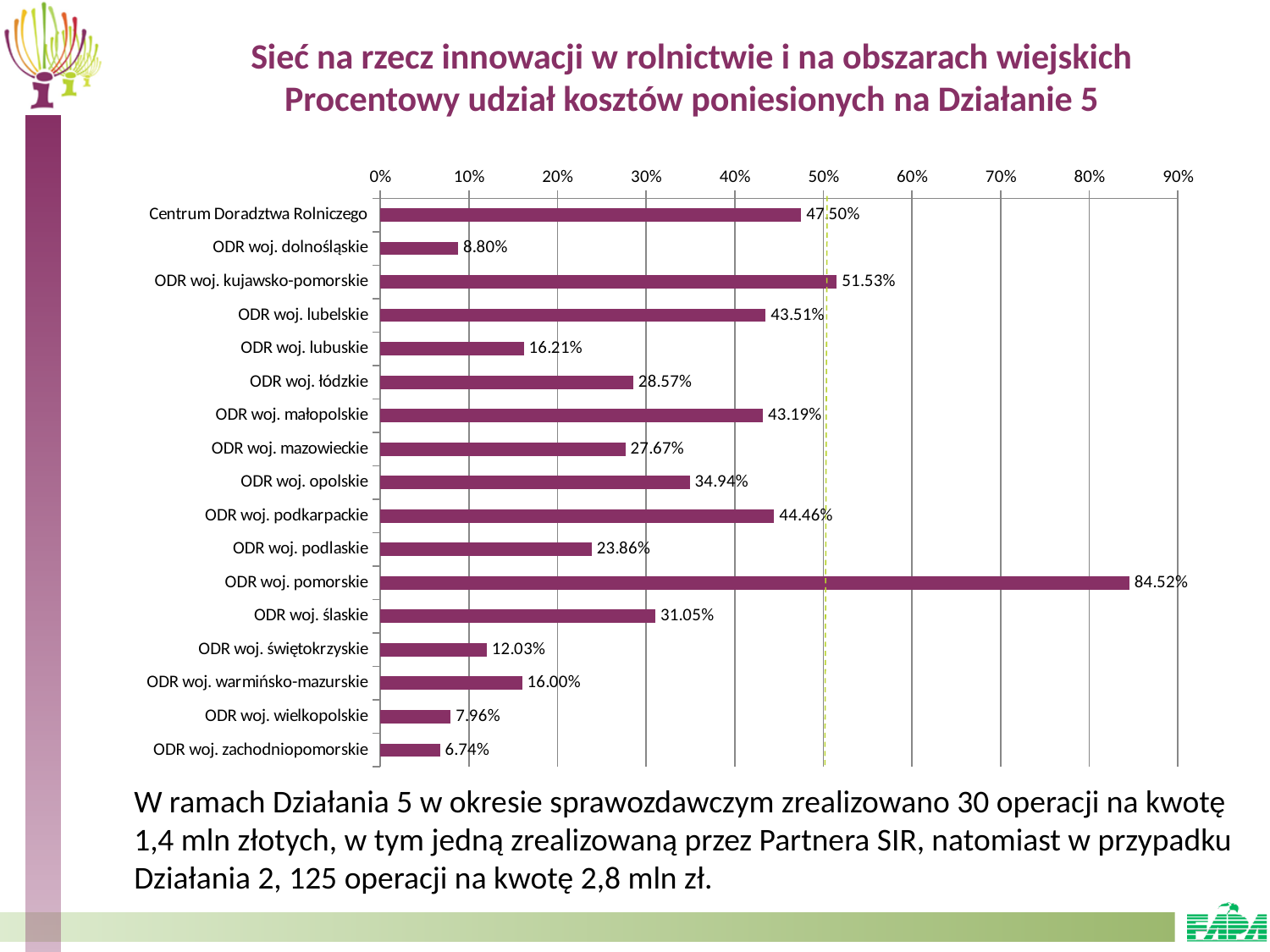
What kind of chart is shown on the slide? bar chart Which category has the lowest value? ODR woj. zachodniopomorskie How many categories are shown in the chart? 17 What is the difference between the values for ODR woj. dolnośląskie and ODR woj. wielkopolskie? 0.84% Which category has the highest value? ODR woj. pomorskie What is the difference between the values for ODR woj. pomorskie and ODR woj. kujawsko-pomorskie? 32.99% What is the value for ODR woj. świętokrzyskie? 12.03% Which is larger, the value for ODR woj. opolskie or the value for ODR woj. podlaskie? ODR woj. opolskie What is the value for ODR woj. pomorskie? 84.52% What is the value for Centrum Doradztwa Rolniczego? 47.50% What is the highest value shown on the horizontal axis of the chart? 90% Is the value for ODR woj. łódzkie greater or less than 30%? less